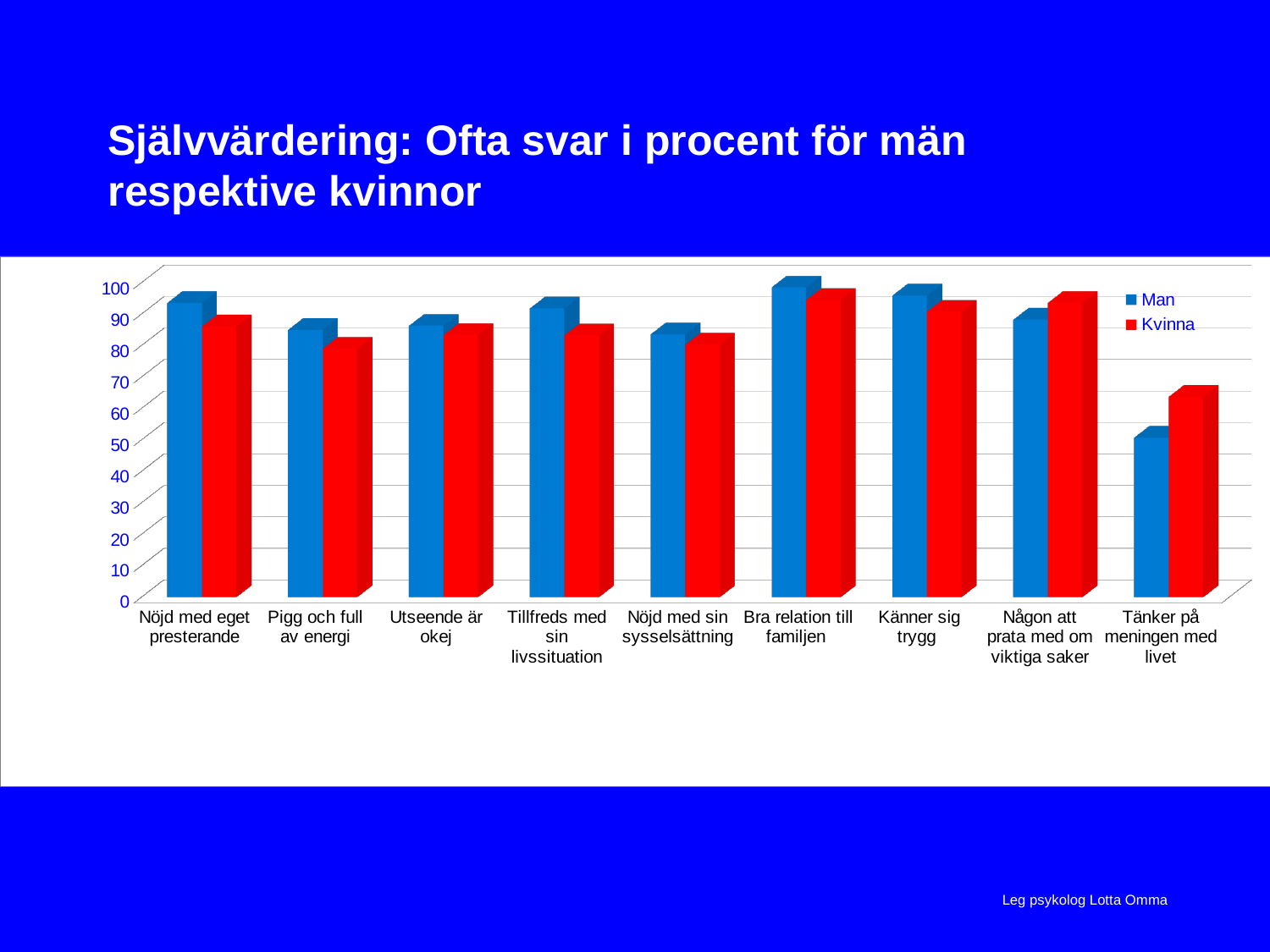
For which category is the Kvinna value lowest? Tänker på meningen med livet For which category is the Man value highest? Bra relation till familjen What kind of chart is shown on the slide? bar chart For 'Nöjd med eget presterande', which is larger: Man or Kvinna? Man How many categories are shown along the x axis? 9 Which colour represents the Kvinna series in the legend? red How many series does the legend list? 2 Is the Kvinna value for 'Tänker på meningen med livet' greater or less than 50? greater For which category is the Man value lowest? Tänker på meningen med livet Is the Man value for 'Bra relation till familjen' greater or less than 90? greater For 'Tänker på meningen med livet', which is larger: Man or Kvinna? Kvinna Is the Man value for 'Tänker på meningen med livet' greater or less than 60? less